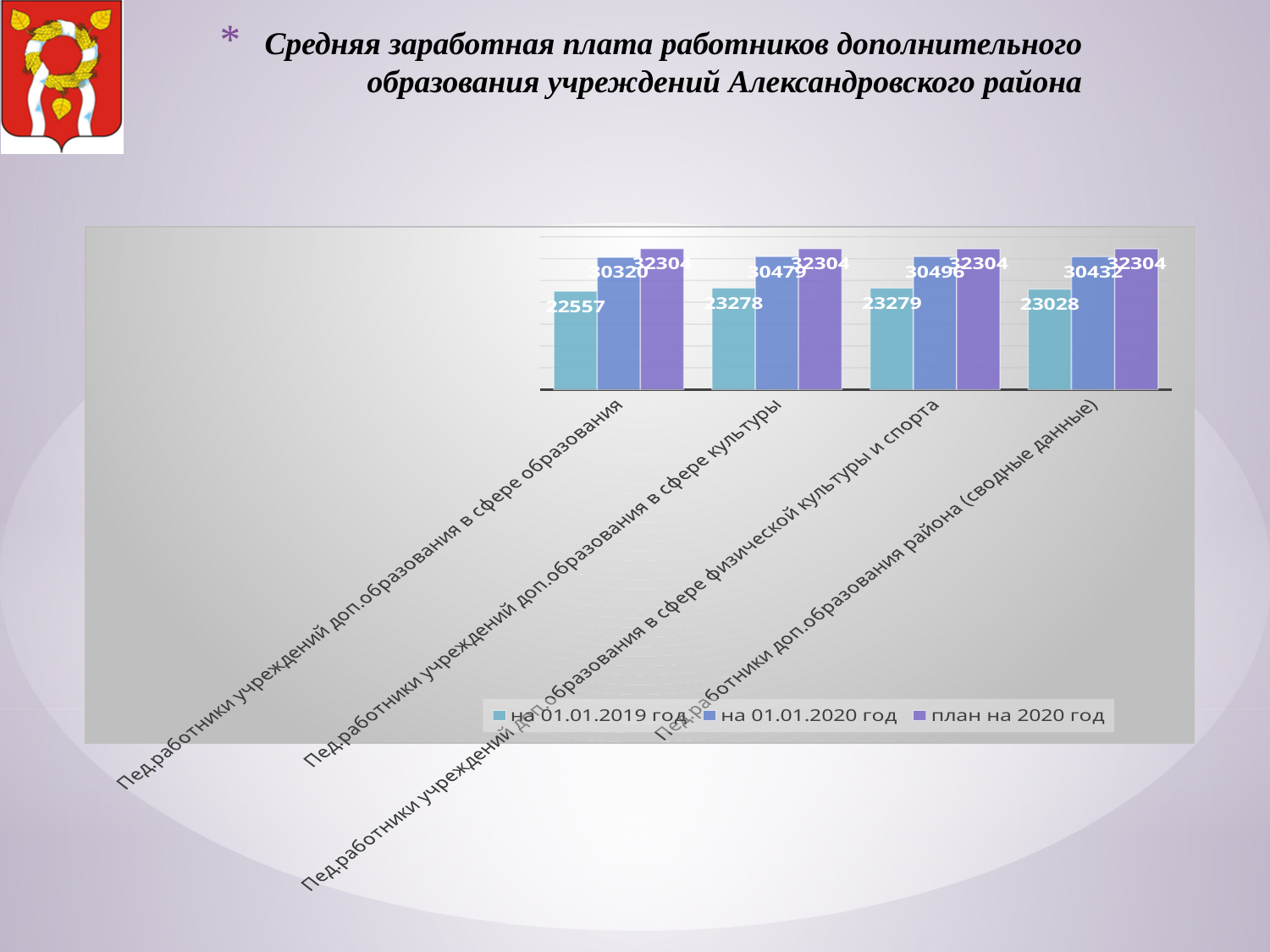
Which category has the lowest value for 'на 01.01.2019 год'? Пед.работники учреждений доп.образования в сфере образования What is the difference between 'план на 2020 год' and 'на 01.01.2020 год' for 'Пед.работники учреждений доп.образования в сфере образования'? 1984 What is the value for 'на 01.01.2020 год' for 'Пед.работники учреждений доп.образования в сфере культуры'? 30479 What is the difference between the 'на 01.01.2020 год' values for 'в сфере физической культуры и спорта' and 'в сфере образования'? 176 What is the value for 'на 01.01.2019 год' for 'Пед.работники доп.образования района (сводные данные)'? 23028 What is the value for 'на 01.01.2019 год' for 'Пед.работники учреждений доп.образования в сфере образования'? 22557 What is the value for 'план на 2020 год' for 'Пед.работники учреждений доп.образования в сфере физической культуры и спорта'? 32304 What type of chart is shown on the slide? bar chart What is the name of the third series in the legend? план на 2020 год How many series does the legend list? 3 Which is larger for 'Пед.работники доп.образования района (сводные данные)': the value for 'на 01.01.2019 год' or for 'на 01.01.2020 год'? на 01.01.2020 год How many categories are shown on the x axis? 4